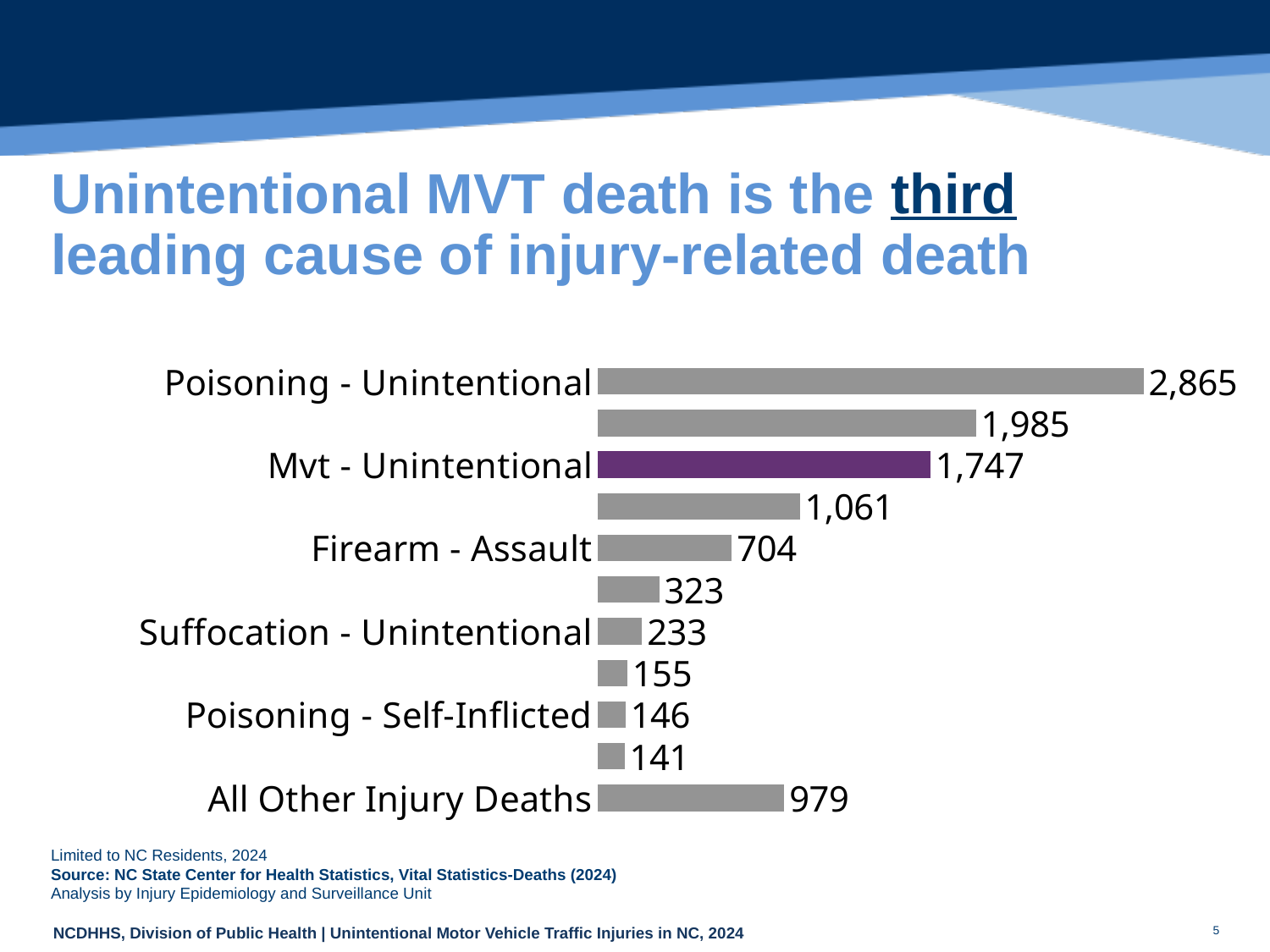
What is the value for Mvt - Unintentional? 1,747 How many bars are plotted on the chart? 11 What is the value for All Other Injury Deaths? 979 What kind of chart is shown on the slide? bar chart What is the value for Firearm - Assault? 704 What is the value for Poisoning - Unintentional? 2,865 What is the value for Poisoning - Self-Inflicted? 146 Which is larger, Firearm - Assault or All Other Injury Deaths? All Other Injury Deaths Which category has the highest value? Poisoning - Unintentional What is the value for Suffocation - Unintentional? 233 What is the smallest value shown on the chart? 141 What is the difference between Poisoning - Unintentional and Mvt - Unintentional? 1,118